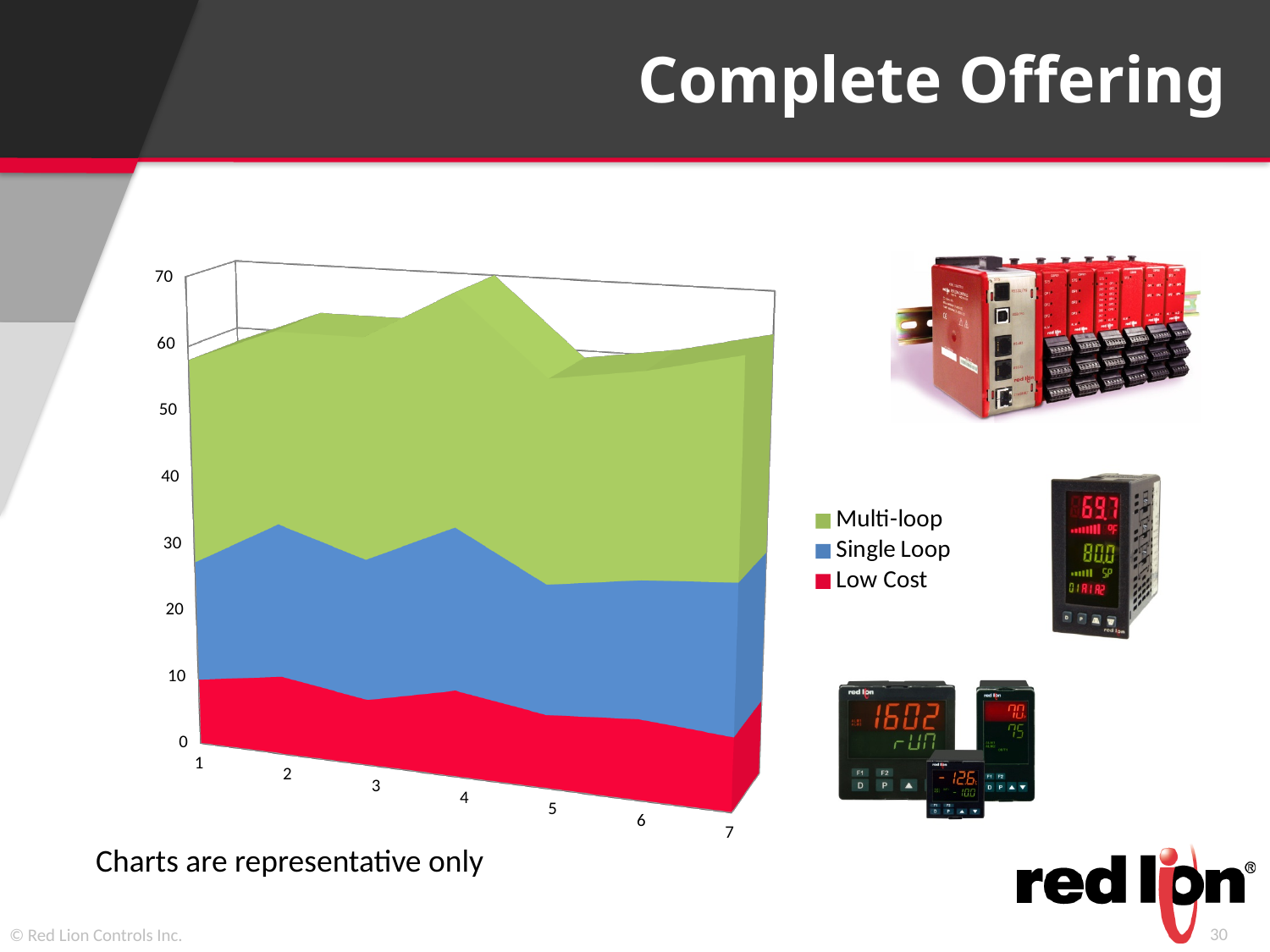
What kind of chart is shown on the slide? area chart Is the stacked total at category 5 greater or less than 70? less Which series occupies the largest band of the stacked area chart? Multi-loop Which series is shown in green in the chart? Multi-loop How many series does the chart's legend list? 3 Is the stacked total at category 1 greater or less than 50? greater At which category does the stacked total reach its highest point? 4 Which series is shown in red in the chart? Low Cost How many categories are shown along the x axis of the chart? 7 Is the stacked total at category 4 greater or less than 60? greater